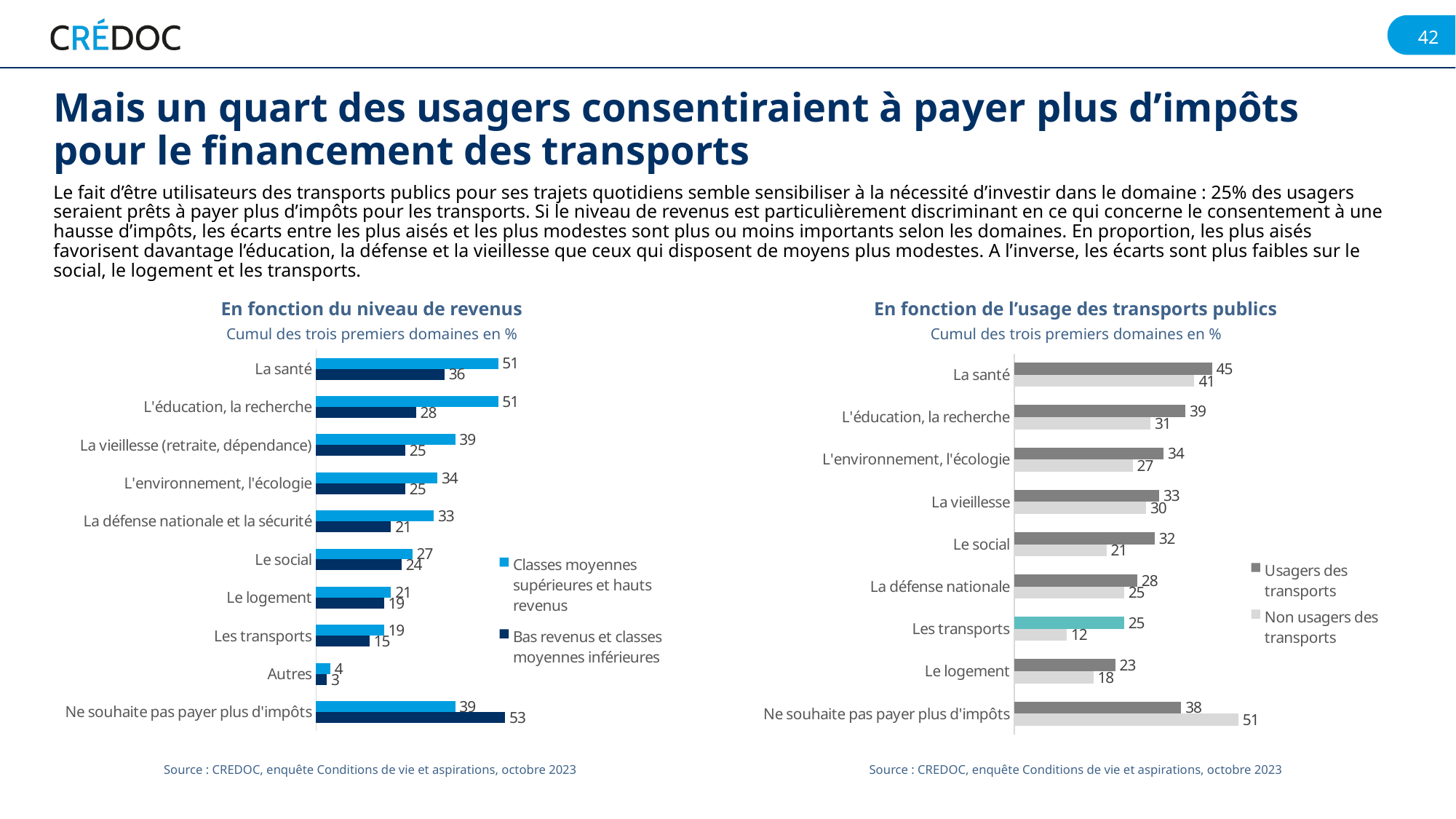
In the chart 'En fonction de l'usage des transports publics', what is the value for 'Le social' for 'Non usagers des transports'? 21 In the chart 'En fonction du niveau de revenus', what is the value for 'Ne souhaite pas payer plus d'impôts' for the series 'Bas revenus et classes moyennes inférieures'? 53 How many series does the legend of the chart 'En fonction du niveau de revenus' list? 2 In the chart 'En fonction du niveau de revenus', what is the difference between the two series for 'L'éducation, la recherche'? 23 What type of chart is 'En fonction de l'usage des transports publics'? Bar chart In the chart 'En fonction du niveau de revenus', which category has the lowest value for the series 'Bas revenus et classes moyennes inférieures'? Autres In the chart 'En fonction de l'usage des transports publics', which is larger for 'La santé': the value for 'Usagers des transports' or for 'Non usagers des transports'? Usagers des transports In the chart 'En fonction de l'usage des transports publics', which category has the highest value for 'Non usagers des transports'? Ne souhaite pas payer plus d'impôts In the chart 'En fonction de l'usage des transports publics', what is the value for 'Les transports' for 'Usagers des transports'? 25 In the chart 'En fonction du niveau de revenus', what is the value for 'La santé' for the series 'Classes moyennes supérieures et hauts revenus'? 51 How many categories are shown in the chart 'En fonction de l'usage des transports publics'? 9 How many categories are shown in the chart 'En fonction du niveau de revenus'? 10